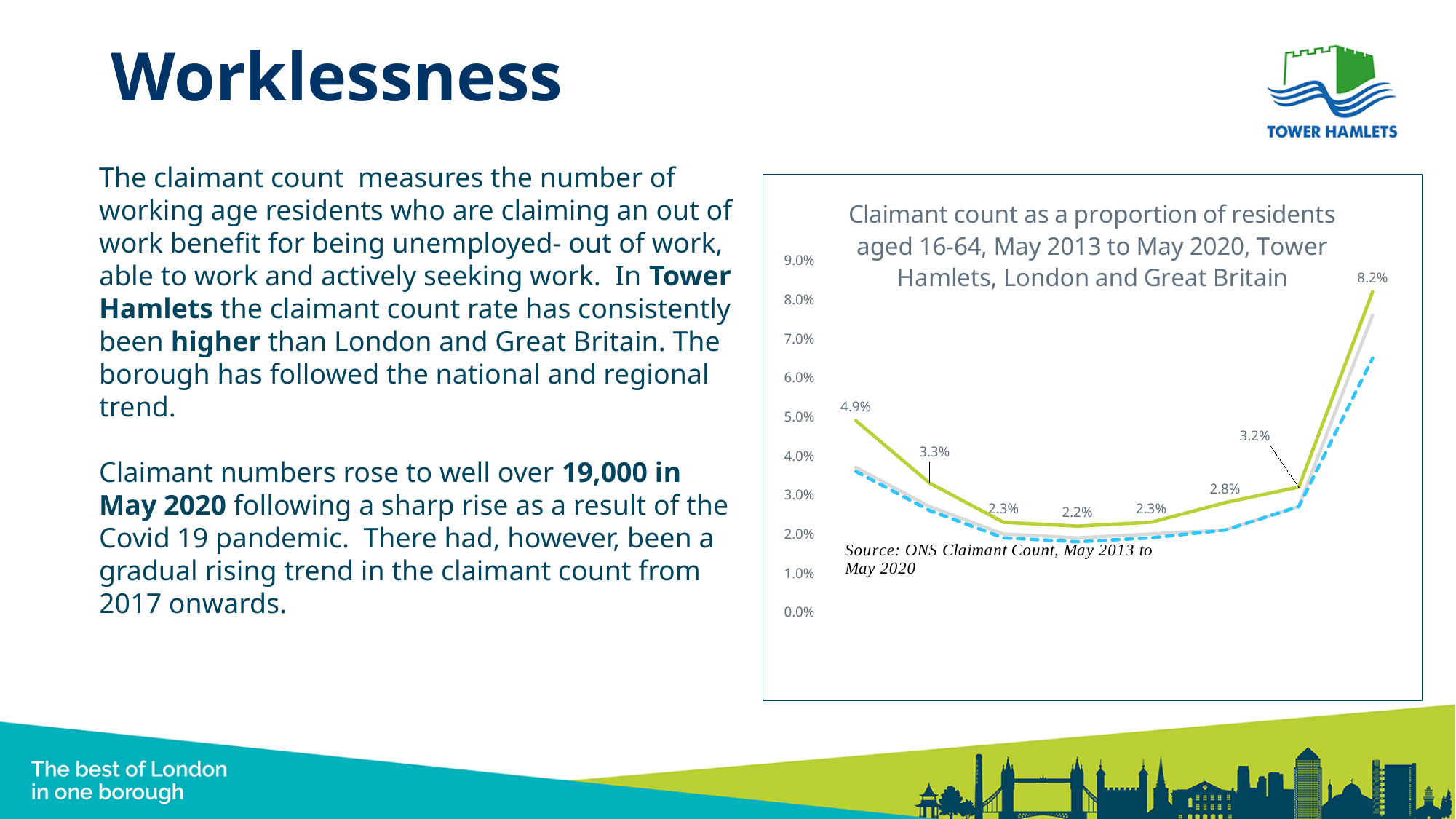
Is the final value of the dashed blue line greater or less than 7.0%? less What is the lowest labelled value on the green line? 2.2% What is the last labelled value on the green line? 8.2% Which is larger on the green line: the first labelled value or the last labelled value? The last labelled value (8.2%) Do the values on the green line rise or fall between the first labelled point (4.9%) and the fourth labelled point (2.2%)? Fall What is the first labelled value on the green line? 4.9% What kind of chart is shown on the slide? Line chart What is the difference between the last labelled value (8.2%) and the first labelled value (4.9%) on the green line? 3.3 percentage points What is the title of the chart? Claimant count as a proportion of residents aged 16-64, May 2013 to May 2020, Tower Hamlets, London and Great Britain How many lines are plotted on the chart? 3 How many data points are labelled on the green line? 8 What is the highest labelled value on the green line? 8.2%